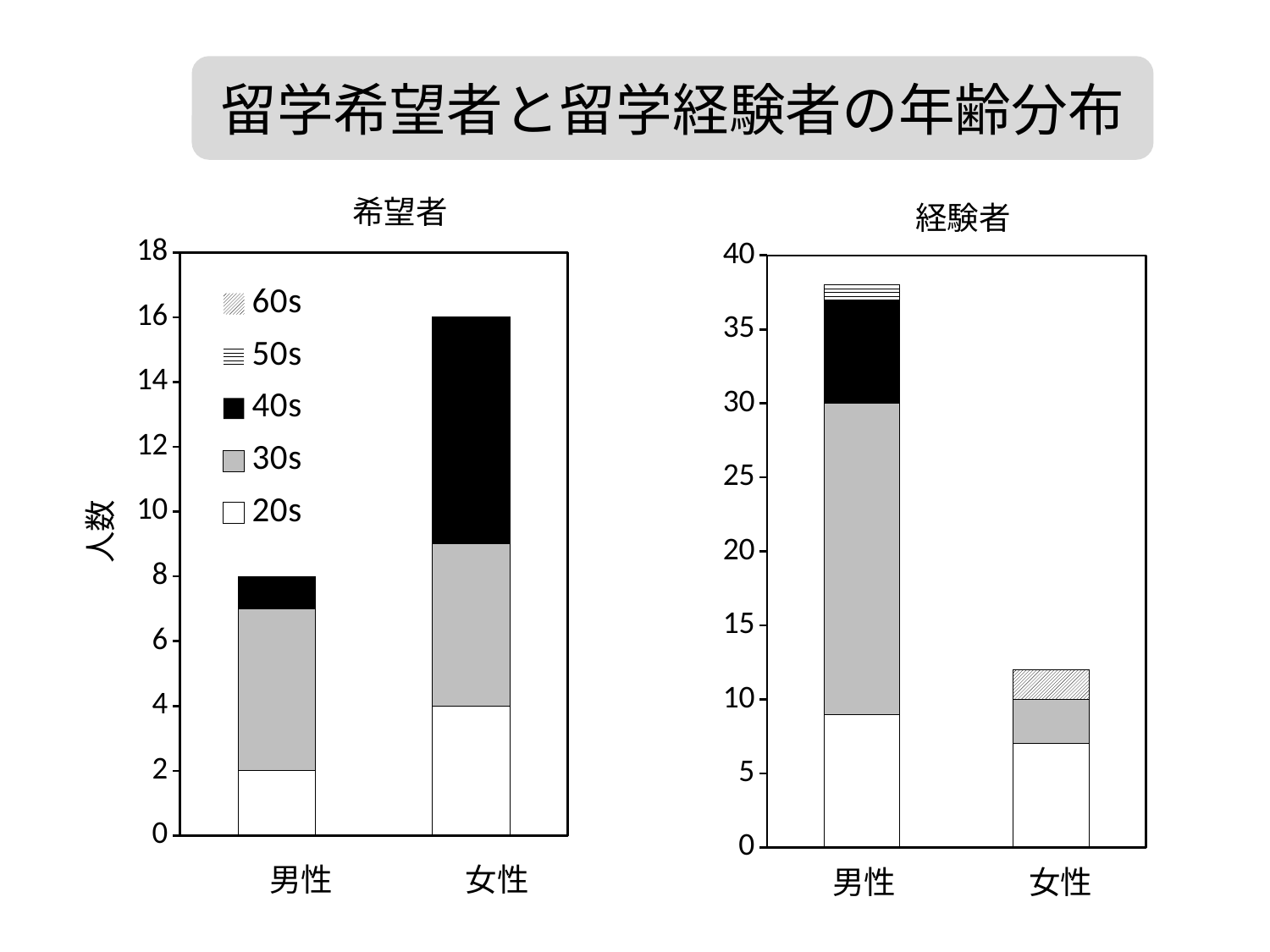
What kind of chart is the 希望者 chart? stacked bar chart In the 希望者 chart, what is the total height of the 男性 bar? 8 In the 希望者 chart, what is the total height of the 女性 bar? 16 How many series does the legend on the 希望者 chart list? 5 In the 希望者 chart, what is the value of the 20s segment for 男性? 2 In the 希望者 chart, what is the difference between the total for 女性 and the total for 男性? 8 In the 経験者 chart, is the total for 女性 greater or less than 15? less How many categories are shown on the x axis of the 経験者 chart? 2 In the 経験者 chart, is the total for 男性 greater or less than 35? greater In the 経験者 chart, which category has the shorter bar? 女性 In the 希望者 chart, which category has the taller bar? 女性 In the 希望者 chart, what is the value of the 20s segment for 女性? 4